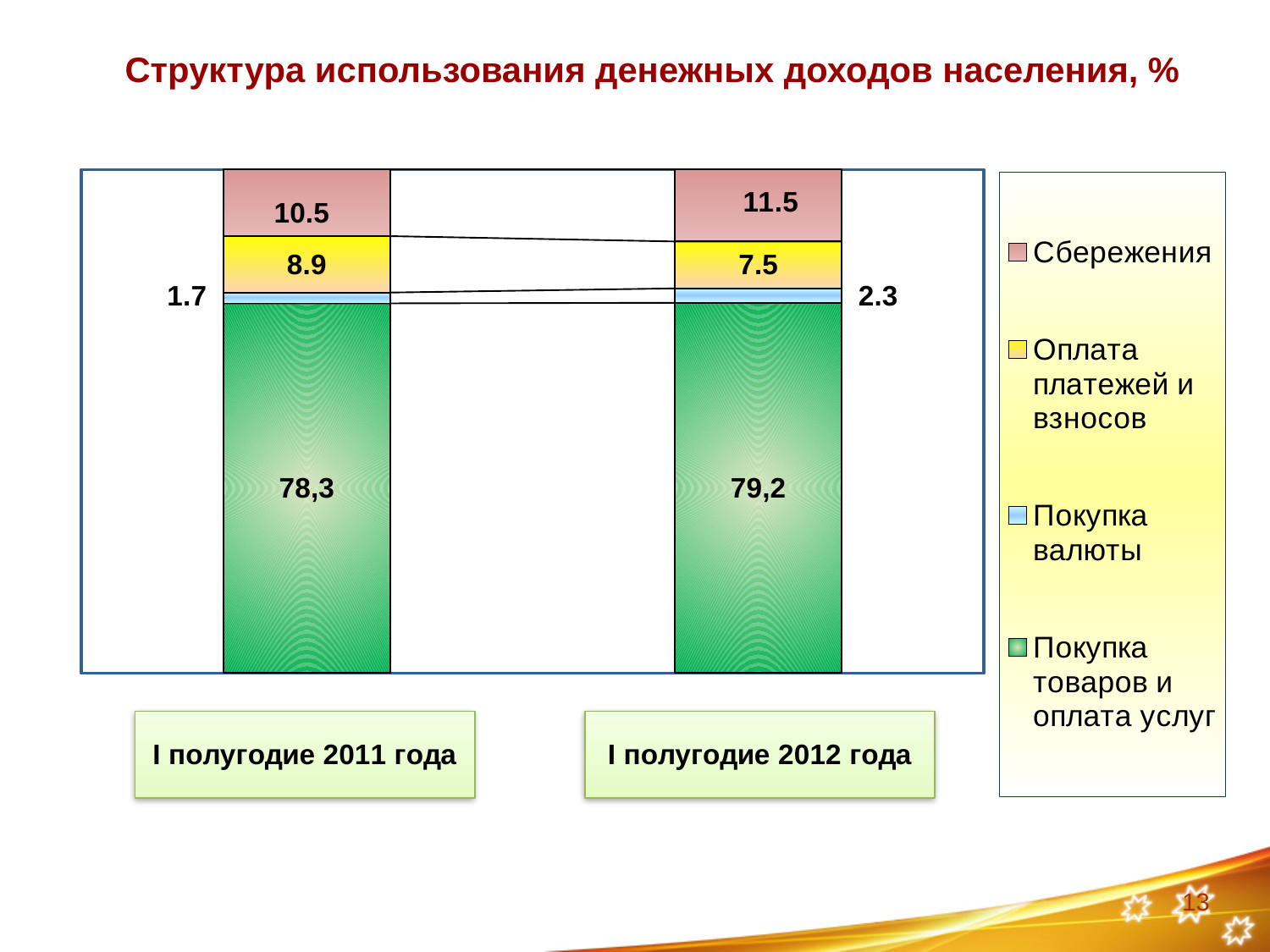
What is the value for Покупка валюты in I полугодие 2011 года? 1.7 What is the value for Оплата платежей и взносов in I полугодие 2012 года? 7.5 What is the value for Сбережения in I полугодие 2012 года? 11.5 Which period has the larger value for Оплата платежей и взносов, I полугодие 2011 года or I полугодие 2012 года? I полугодие 2011 года What is the value for Сбережения in I полугодие 2011 года? 10.5 What type of chart is shown on the slide? stacked bar chart What is the value for Покупка товаров и оплата услуг in I полугодие 2012 года? 79,2 How many series does the legend list? 4 What is the difference in Покупка валюты between I полугодие 2012 года and I полугодие 2011 года? 0.6 Which series is the largest segment in the I полугодие 2011 года bar? Покупка товаров и оплата услуг How many bars (periods) are shown in the chart? 2 What is the difference in Сбережения between I полугодие 2012 года and I полугодие 2011 года? 1.0